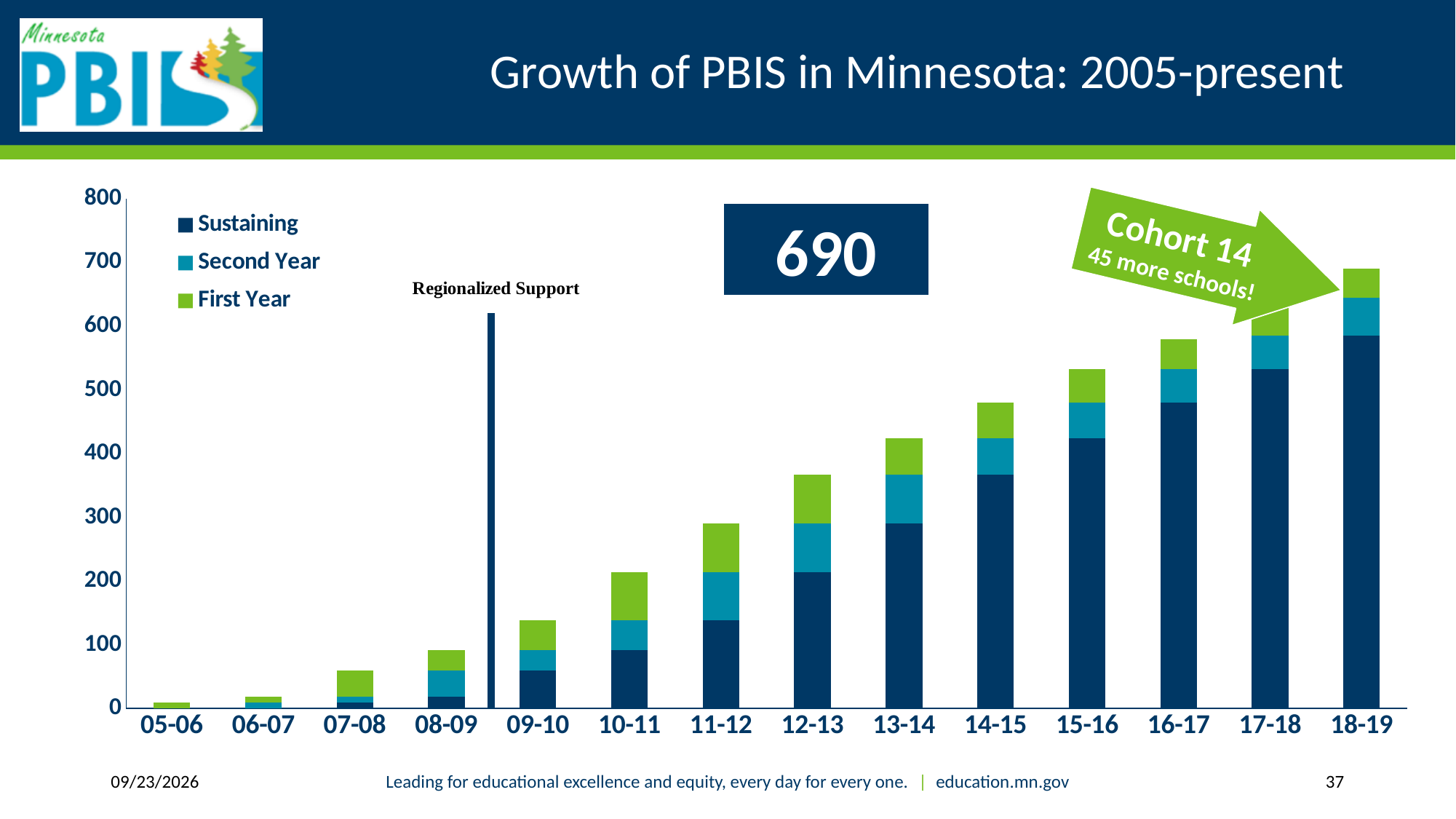
Is the total height of the 14-15 bar greater or less than 500? less What kind of chart is shown on the slide? Stacked bar chart Is the total height of the 18-19 bar greater or less than 600? greater Which school year has the shortest stacked bar? 05-06 Which school year has the tallest stacked bar? 18-19 Is the total height of the 09-10 bar greater or less than 200? less How many series does the chart legend list? 3 Do the stacked bar totals rise or fall from 05-06 to 18-19? rise What are the three series named in the legend? Sustaining, Second Year, First Year How many school-year categories are shown on the x axis? 14 Which bar is taller, 17-18 or 10-11? 17-18